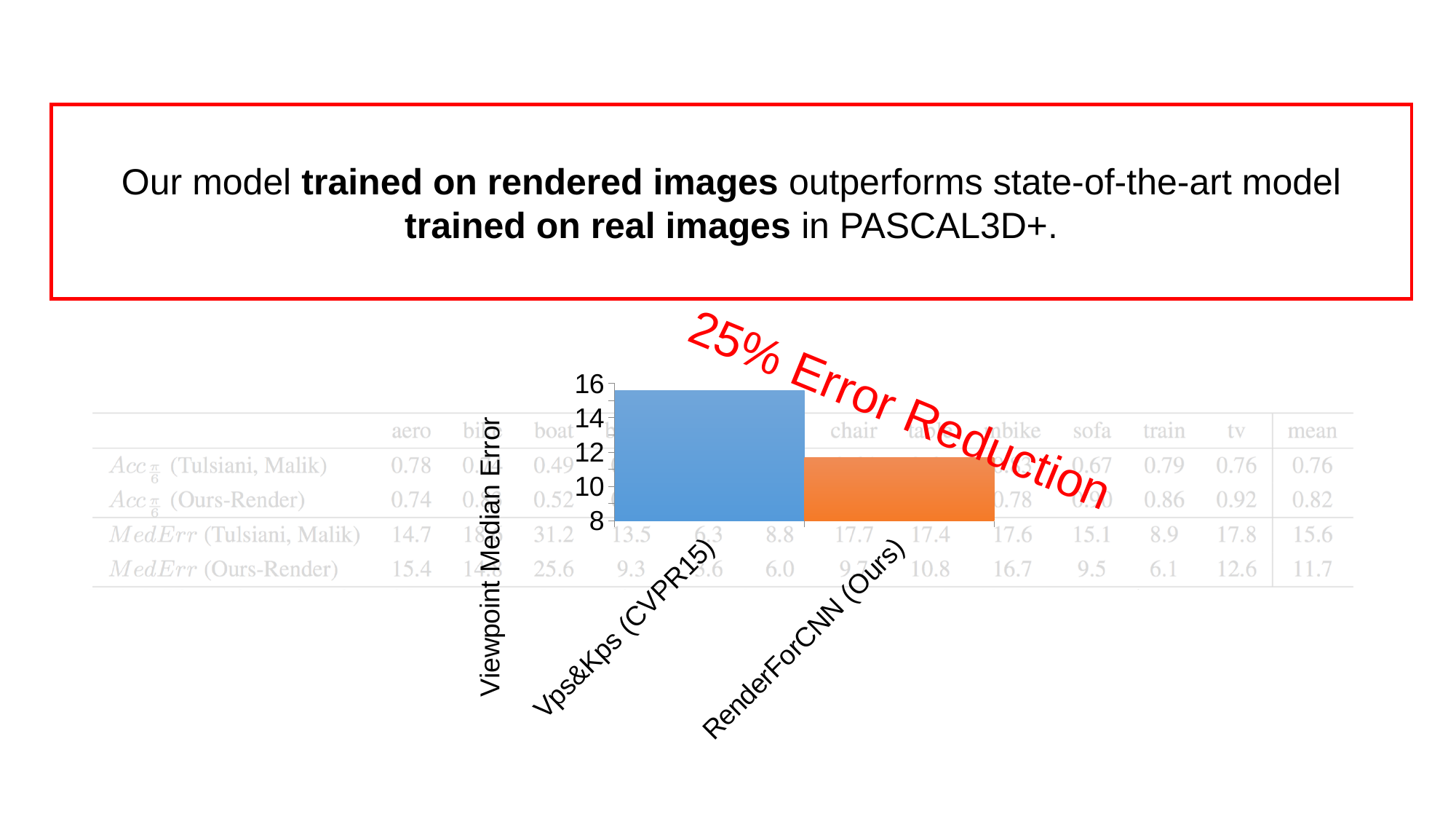
Which bar is taller: Vps&Kps (CVPR15) or RenderForCNN (Ours)? Vps&Kps (CVPR15) Which method has the lower Viewpoint Median Error in the chart? RenderForCNN (Ours) Is the Viewpoint Median Error for RenderForCNN (Ours) greater or less than 10? greater How many bars does the chart show? 2 What is the label on the vertical axis of the chart? Viewpoint Median Error Is the Viewpoint Median Error for Vps&Kps (CVPR15) greater or less than 14? greater What error reduction does the red annotation over the chart claim? 25% Error Reduction Which method has the higher Viewpoint Median Error in the chart? Vps&Kps (CVPR15) What kind of chart is shown on the slide? bar chart